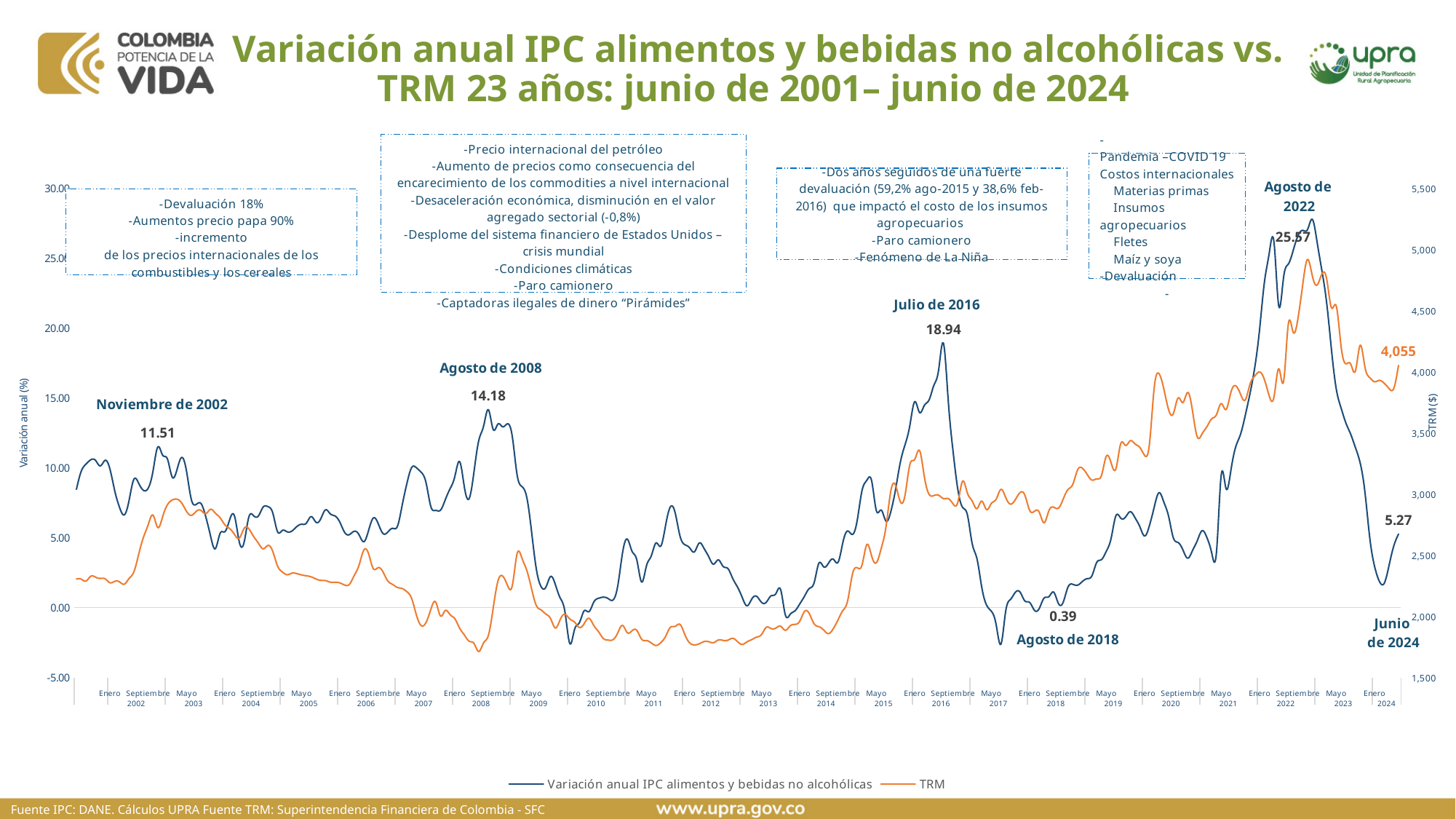
What was the annual IPC variation for food and non-alcoholic beverages in Julio de 2016? 18.94 What was the annual IPC variation for food and non-alcoholic beverages in Agosto de 2018? 0.39 Which labelled point has the highest annual IPC variation? Agosto de 2022 What was the annual IPC variation for food and non-alcoholic beverages in Agosto de 2008? 14.18 How many series does the legend list? 2 Which labelled point has the lowest annual IPC variation? Agosto de 2018 What is the TRM value labelled at the end of the series in June 2024? 4,055 What is the difference between the annual IPC variation in Agosto de 2022 and in Julio de 2016? 6.63 What was the annual IPC variation for food and non-alcoholic beverages in Noviembre de 2002? 11.51 Which is larger, the annual IPC variation in Agosto de 2008 or in Noviembre de 2002? Agosto de 2008 What kind of chart is shown on the slide? line chart What was the annual IPC variation for food and non-alcoholic beverages in Agosto de 2022? 25.57